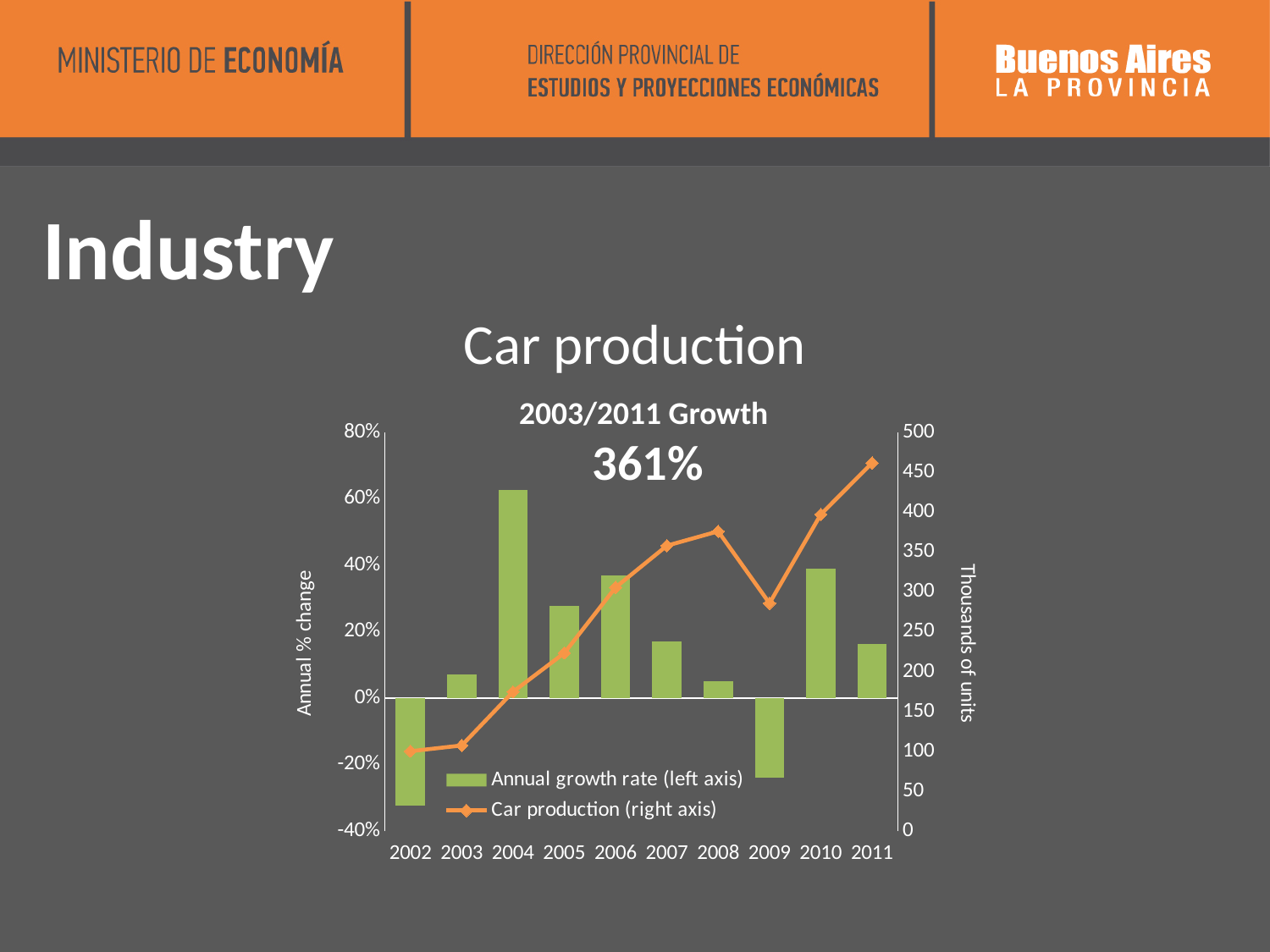
In which year does the car production line reach its highest point? 2011 How many series does the legend list? 2 Is the annual growth rate for 2004 greater or less than 40%? greater What is the 2003/2011 growth figure shown on the Car production chart? 361% Which year has the higher annual growth rate, 2010 or 2011? 2010 Is the car production value for 2002 greater or less than 150 thousand units? less Which year has the higher car production, 2008 or 2009? 2008 In which year is the annual growth rate bar lowest? 2002 Does car production rise or fall from 2009 to 2011? rise How many years are shown on the x axis of the chart? 10 In which year is the annual growth rate bar highest? 2004 Is the car production value for 2011 greater or less than 400 thousand units? greater